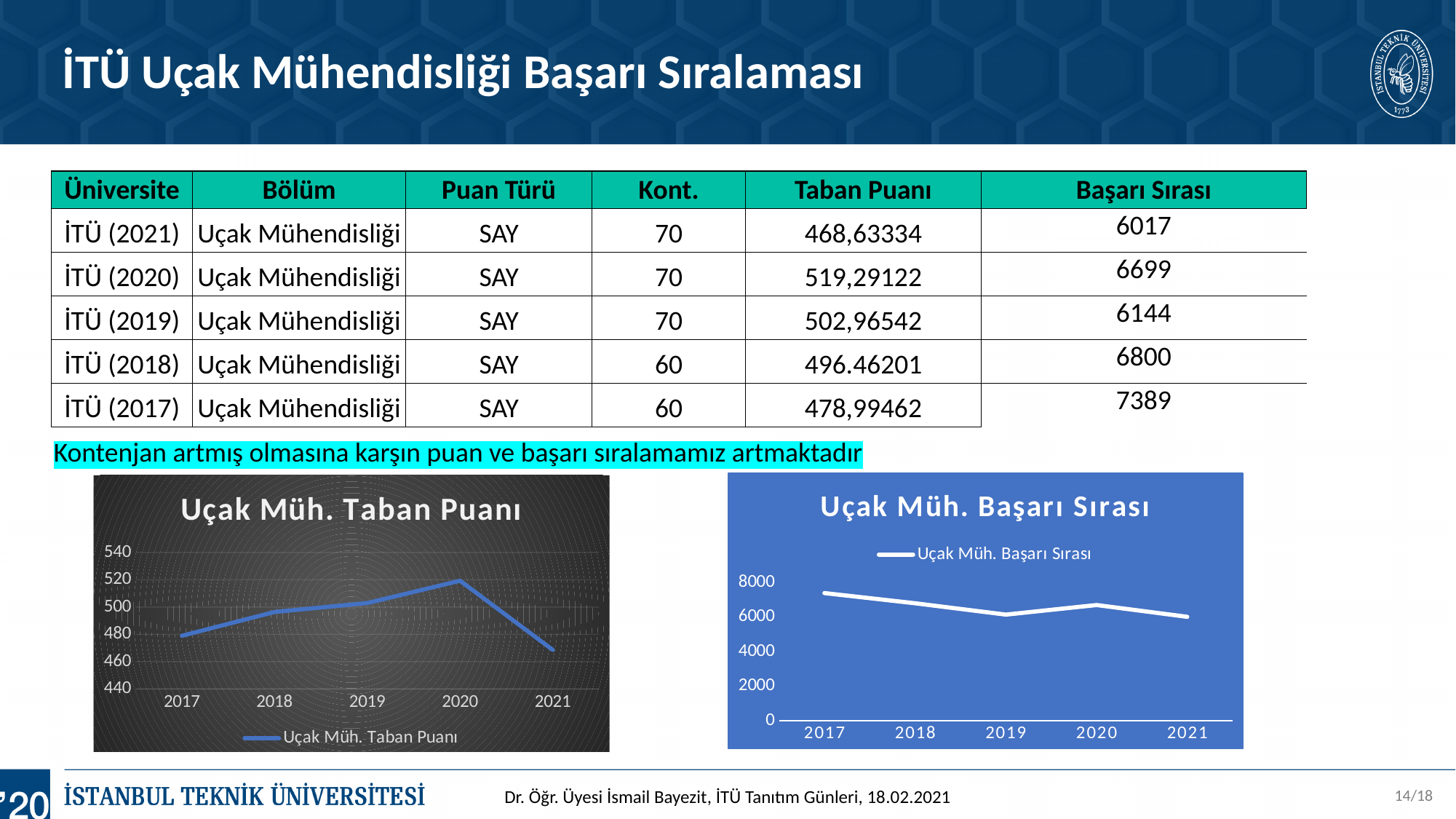
In the 'Uçak Müh. Başarı Sırası' chart, which is larger, the value for 2018 or the value for 2019? 2018 In the 'Uçak Müh. Başarı Sırası' chart, which year has the highest value? 2017 In the 'Uçak Müh. Taban Puanı' chart, is the value for 2021 greater or less than 480? less In the 'Uçak Müh. Taban Puanı' chart, which year has the lowest value? 2021 In the 'Uçak Müh. Başarı Sırası' chart, do the values generally rise or fall from 2017 to 2021? fall What type of chart is the 'Uçak Müh. Taban Puanı' chart? line chart In the 'Uçak Müh. Taban Puanı' chart, which year has the highest value? 2020 What type of chart is the 'Uçak Müh. Başarı Sırası' chart? line chart In the 'Uçak Müh. Başarı Sırası' chart, is the value for 2017 greater or less than 6000? greater In the 'Uçak Müh. Taban Puanı' chart, is the value for 2020 greater or less than 500? greater How many series does the legend of the 'Uçak Müh. Başarı Sırası' chart list? 1 How many years are plotted on the x axis of the 'Uçak Müh. Taban Puanı' chart? 5